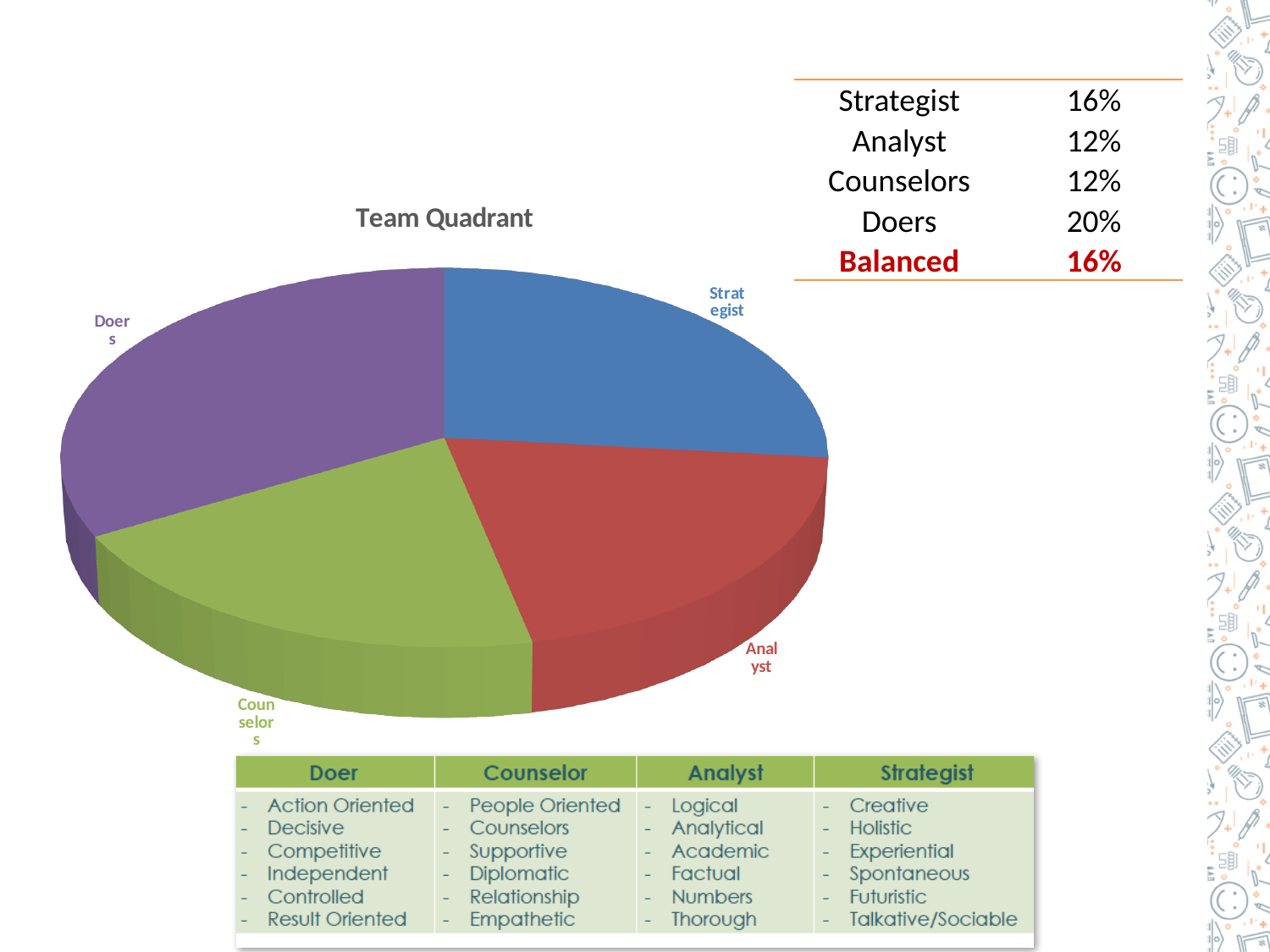
In the Team Quadrant pie chart, which slice is larger, Doers or Strategist? Doers What colour is the Doers slice in the Team Quadrant pie chart? purple In the Team Quadrant pie chart, which slice is larger, Strategist or Analyst? Strategist In the Team Quadrant pie chart, which slice is larger, Doers or Analyst? Doers What kind of chart is shown on the slide? pie chart How many slices does the Team Quadrant pie chart have? 4 Which slice of the Team Quadrant pie chart is the largest? Doers What is the title of the pie chart? Team Quadrant